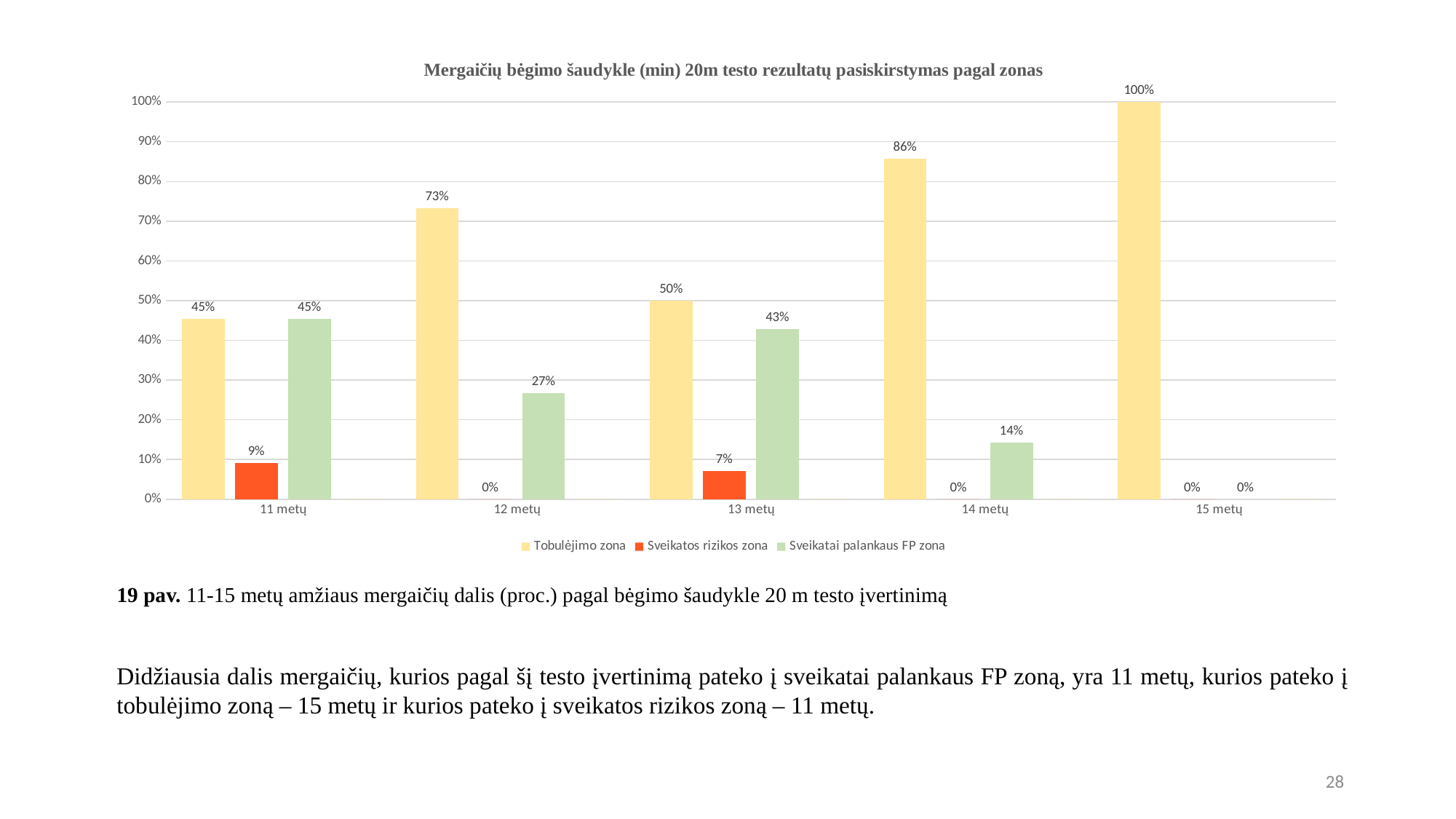
What is the value for Sveikatos rizikos zona at 13 metų? 7% How many series does the legend list? 3 What is the value for Sveikatai palankaus FP zona at 14 metų? 14% Which is larger at 13 metų: Tobulėjimo zona or Sveikatai palankaus FP zona? Tobulėjimo zona Which age group has the lowest value for Sveikatai palankaus FP zona? 15 metų Is the value for Tobulėjimo zona at 14 metų greater or less than 80%? greater Which age group has the highest value for Tobulėjimo zona? 15 metų What is the value for Tobulėjimo zona at 12 metų? 73% What kind of chart is shown on the slide? bar chart Does the value for Tobulėjimo zona rise or fall from 11 metų to 15 metų? rise What is the difference between Tobulėjimo zona and Sveikatai palankaus FP zona at 12 metų? 46% How many age groups are shown on the x axis? 5